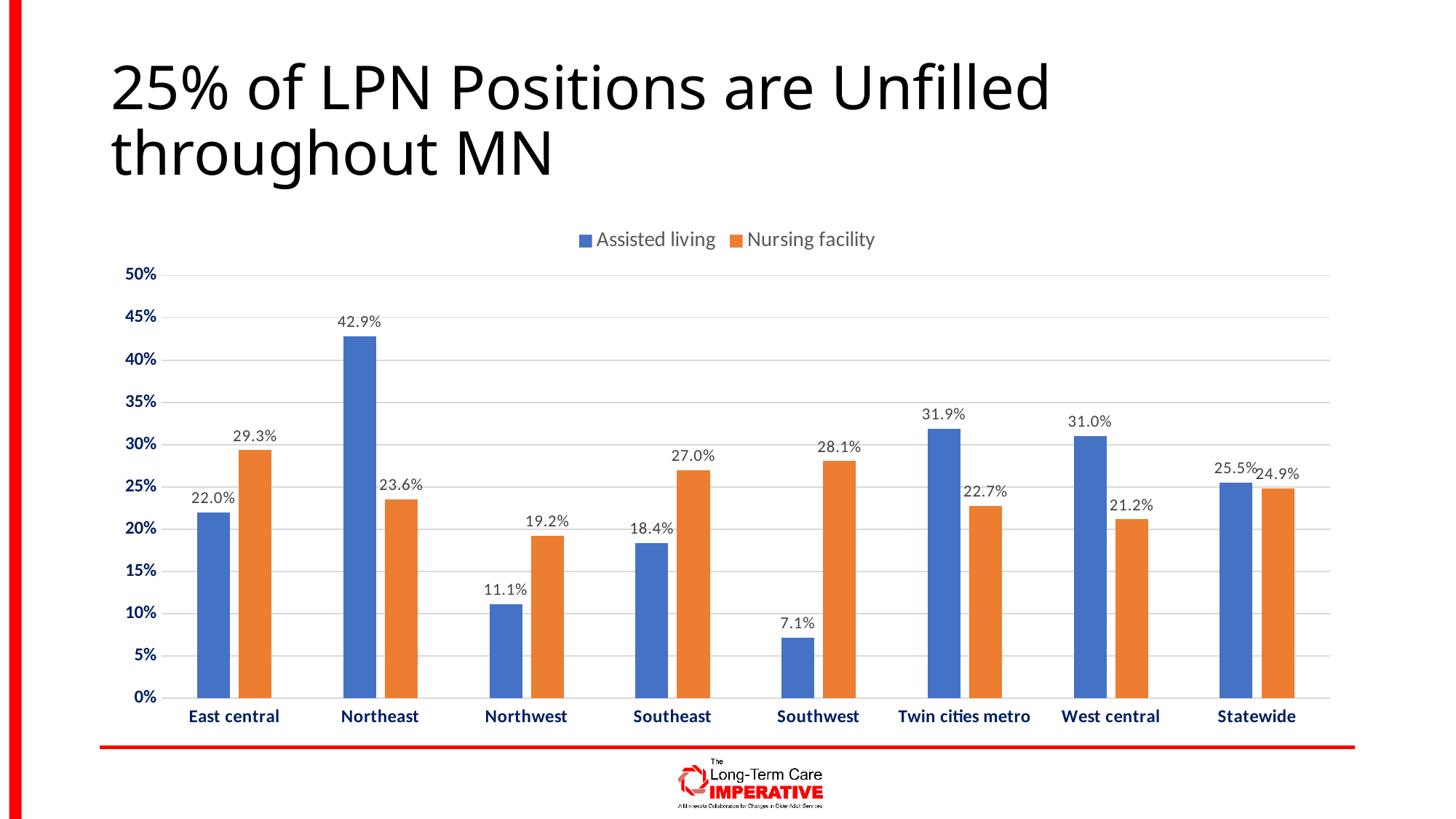
What kind of chart is shown on the slide? Bar chart For East central, which is larger: Assisted living or Nursing facility? Nursing facility Which region has the lowest Assisted living value? Southwest What is the Nursing facility value for Southwest? 28.1% How many categories are shown on the x axis? 8 What is the Assisted living value for Statewide? 25.5% Is the Assisted living value for Twin cities metro greater or less than 30%? greater What is the Assisted living value for Northeast? 42.9% What is the difference between the Assisted living and Nursing facility values for Southwest? 21.0% Which region has the highest Assisted living value? Northeast Which region has the lowest Nursing facility value? Northwest How many series does the legend list? 2